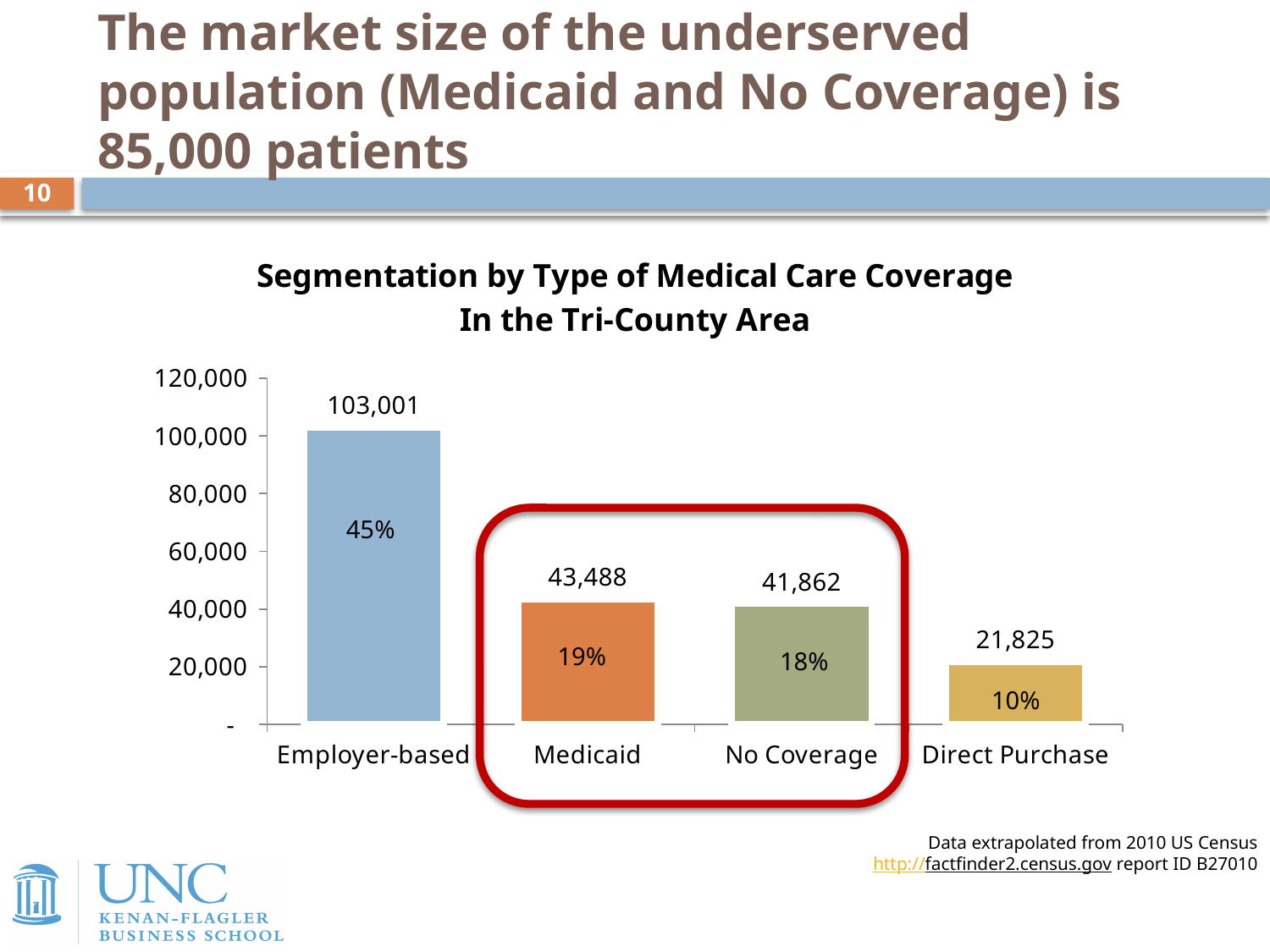
How many categories are shown on the x axis? 4 What is the value for Medicaid? 43,488 Which category has the lowest value? Direct Purchase What percentage share is shown on the Employer-based bar? 45% What is the difference between the Medicaid and No Coverage values? 1,626 Which is larger, the value for Employer-based or the value for Direct Purchase? Employer-based What is the value for No Coverage? 41,862 Which category has the highest value? Employer-based Is the value for Direct Purchase greater or less than 40,000? less What kind of chart is shown on the slide? Bar chart What is the value for Direct Purchase? 21,825 What is the value for Employer-based? 103,001